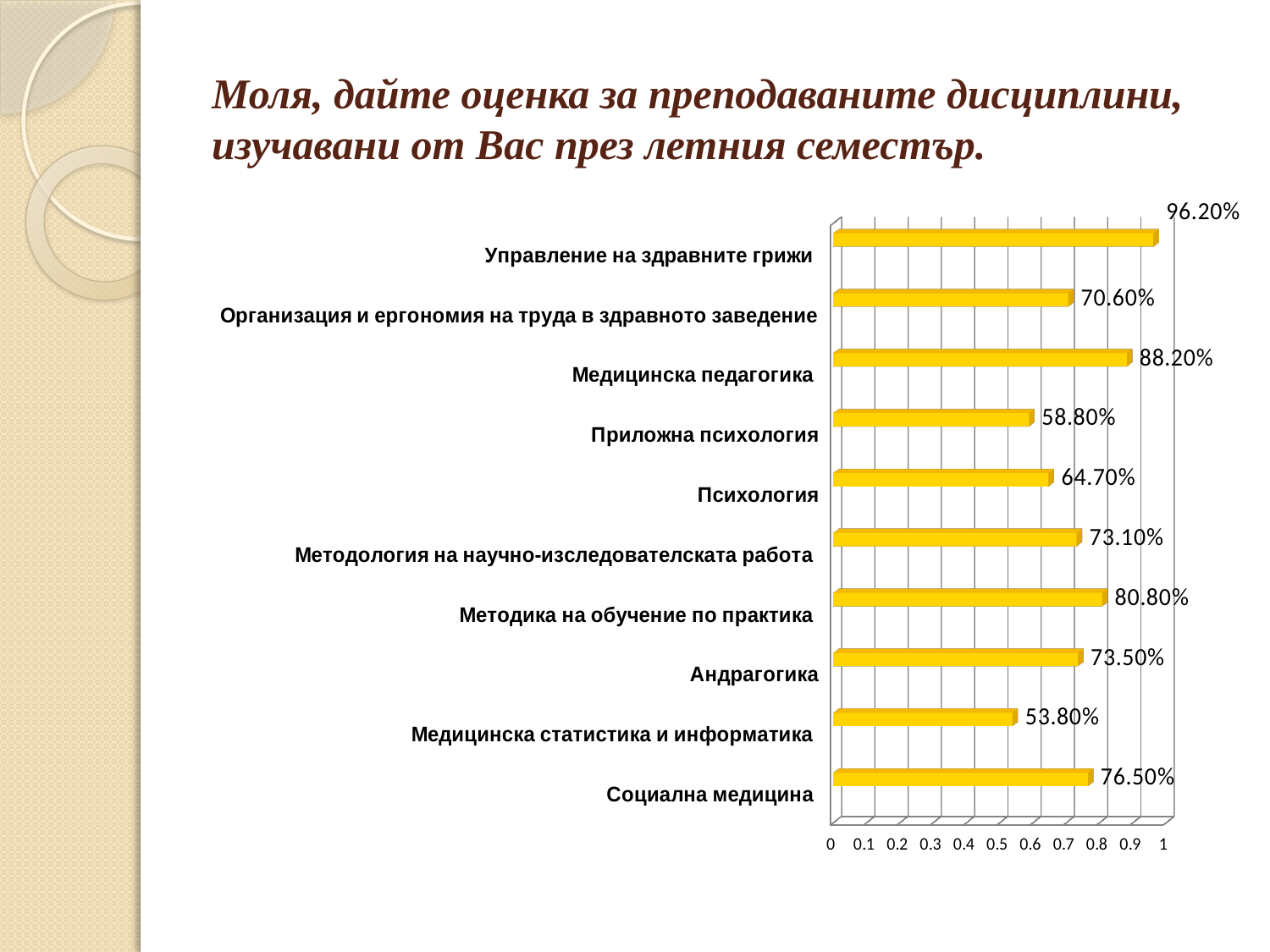
Which has a larger value, Психология or Андрагогика? Андрагогика What kind of chart is shown on the slide? bar chart What is the value for Социална медицина? 76.50% What colour are the bars in the chart? yellow What is the value for Управление на здравните грижи? 96.20% What is the value for Методика на обучение по практика? 80.80% What is the difference between the values for Управление на здравните грижи and Организация и ергономия на труда в здравното заведение? 25.60% What is the difference between the values for Медицинска педагогика and Приложна психология? 29.40% How many disciplines (categories) are plotted in the chart? 10 What is the value for Медицинска статистика и информатика? 53.80% Which discipline has the lowest value? Медицинска статистика и информатика Which discipline has the highest value? Управление на здравните грижи